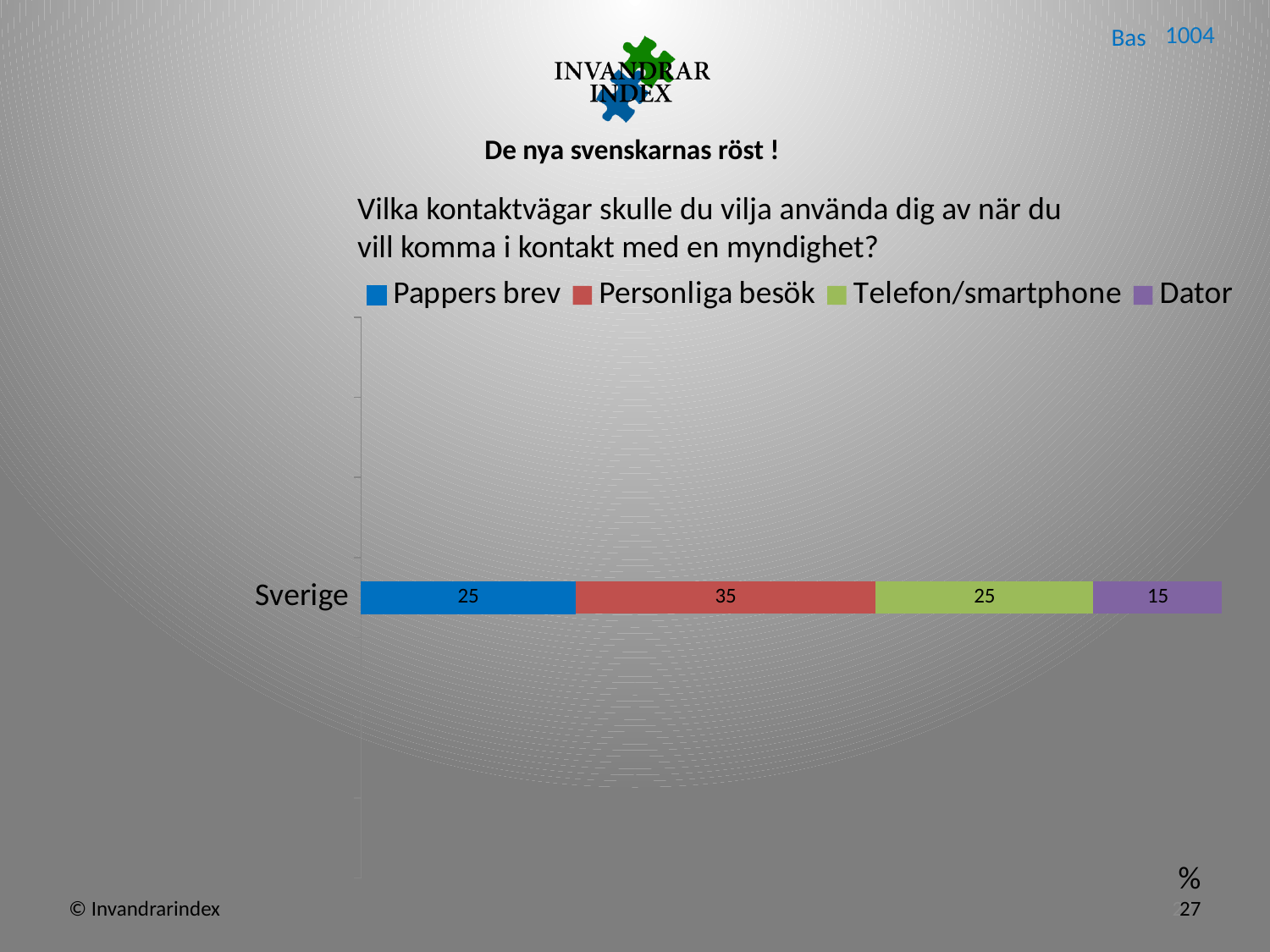
Which series has the highest value for Sverige? Personliga besök Which series has the lowest value for Sverige? Dator What is the value for Dator for Sverige? 15 Which is larger for Sverige, Pappers brev or Personliga besök? Personliga besök What kind of chart is shown on the slide? Stacked bar chart What is the difference between Personliga besök and Dator for Sverige? 20 What is the value for Pappers brev for Sverige? 25 How many categories are shown on the chart? 1 How many series does the legend list? 4 What is the value for Telefon/smartphone for Sverige? 25 What is the total of the stacked bar for Sverige? 100 What is the value for Personliga besök for Sverige? 35